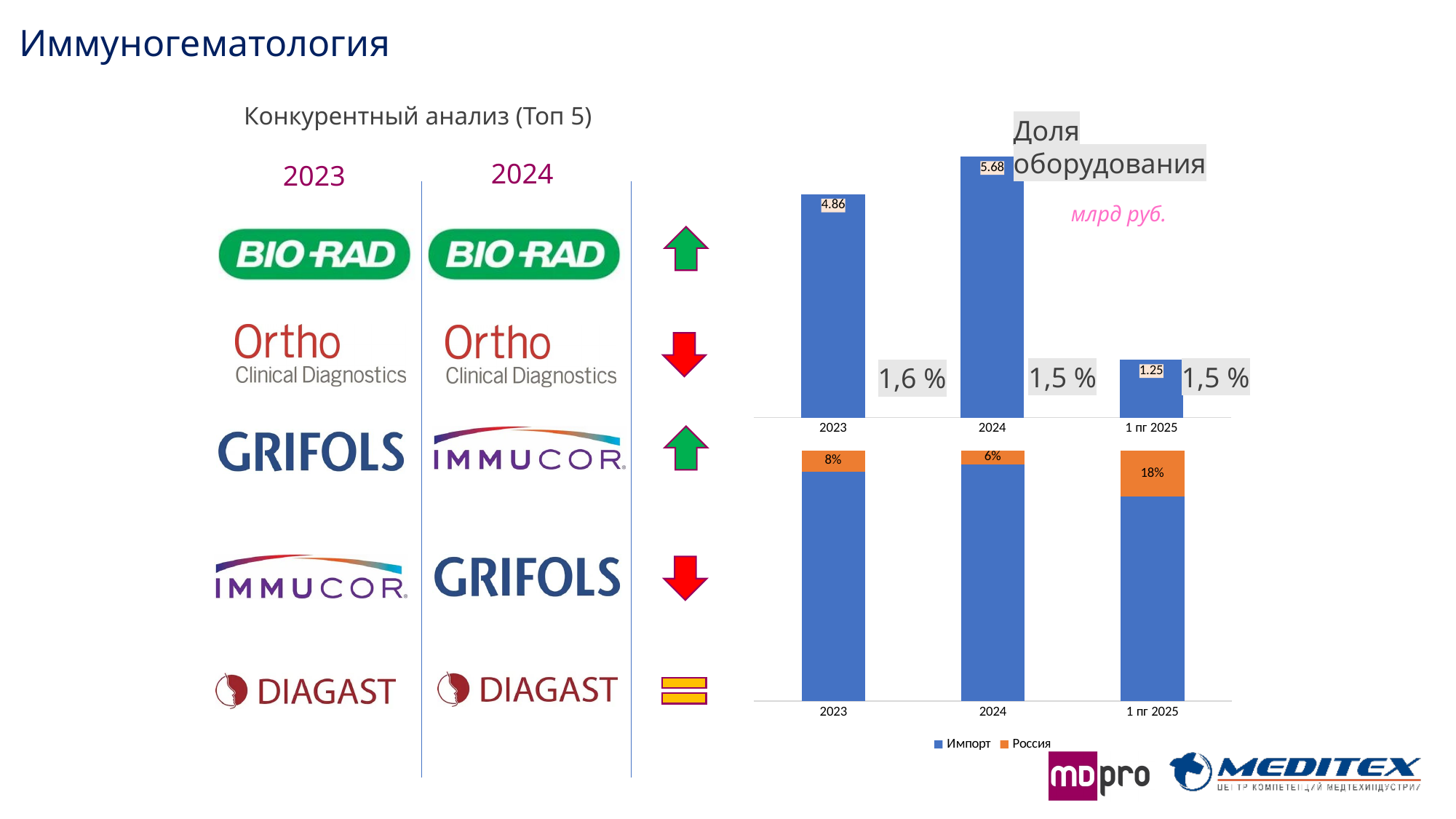
In the bottom stacked bar chart, which series is shown in orange? Россия In the bottom stacked bar chart, what is the Россия share for 2024? 6% In the top bar chart, what is the value for 2024? 5.68 In the top bar chart, what is the value for 1 пг 2025? 1.25 In the top bar chart, what is the value for 2023? 4.86 In the bottom stacked bar chart, what is the Россия share for 1 пг 2025? 18% In the top bar chart, how many bars are plotted? 3 In the bottom stacked bar chart, which year has the largest Россия share? 1 пг 2025 In the bottom stacked bar chart, how many series does the legend list? 2 In the top bar chart, what is the difference between the values for 2024 and 2023? 0.82 In the top bar chart, which category has the highest value? 2024 In the top bar chart, which category has the lowest value? 1 пг 2025